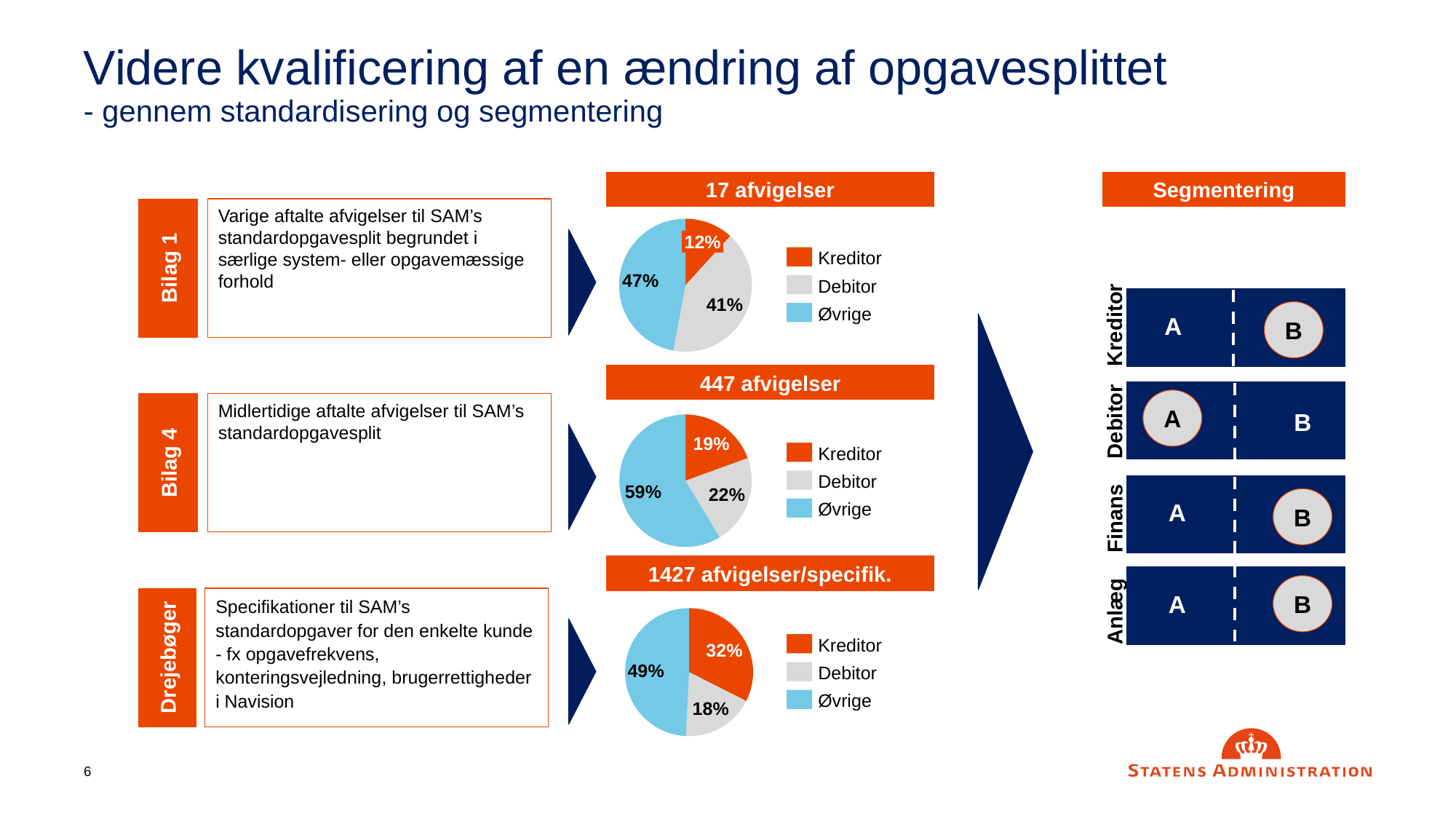
In the '1427 afvigelser/specifik.' chart, what is the difference between the Øvrige share and the Debitor share? 31% In the '1427 afvigelser/specifik.' chart, which is larger, Kreditor or Debitor? Kreditor In the '17 afvigelser' chart, what share does Øvrige have? 47% In the '447 afvigelser' chart, what is the difference between the Øvrige share and the Kreditor share? 40% In the '447 afvigelser' chart, what share does Debitor have? 22% In the '1427 afvigelser/specifik.' chart, which colour represents Øvrige? Light blue In the '17 afvigelser' chart, what share does Kreditor have? 12% What type of chart is the '447 afvigelser' chart? Pie chart In the '447 afvigelser' chart, which category has the smallest share? Kreditor How many categories does the legend of the '17 afvigelser' chart list? 3 In the '17 afvigelser' chart, which category has the largest share? Øvrige In the '1427 afvigelser/specifik.' chart, what share does Kreditor have? 32%